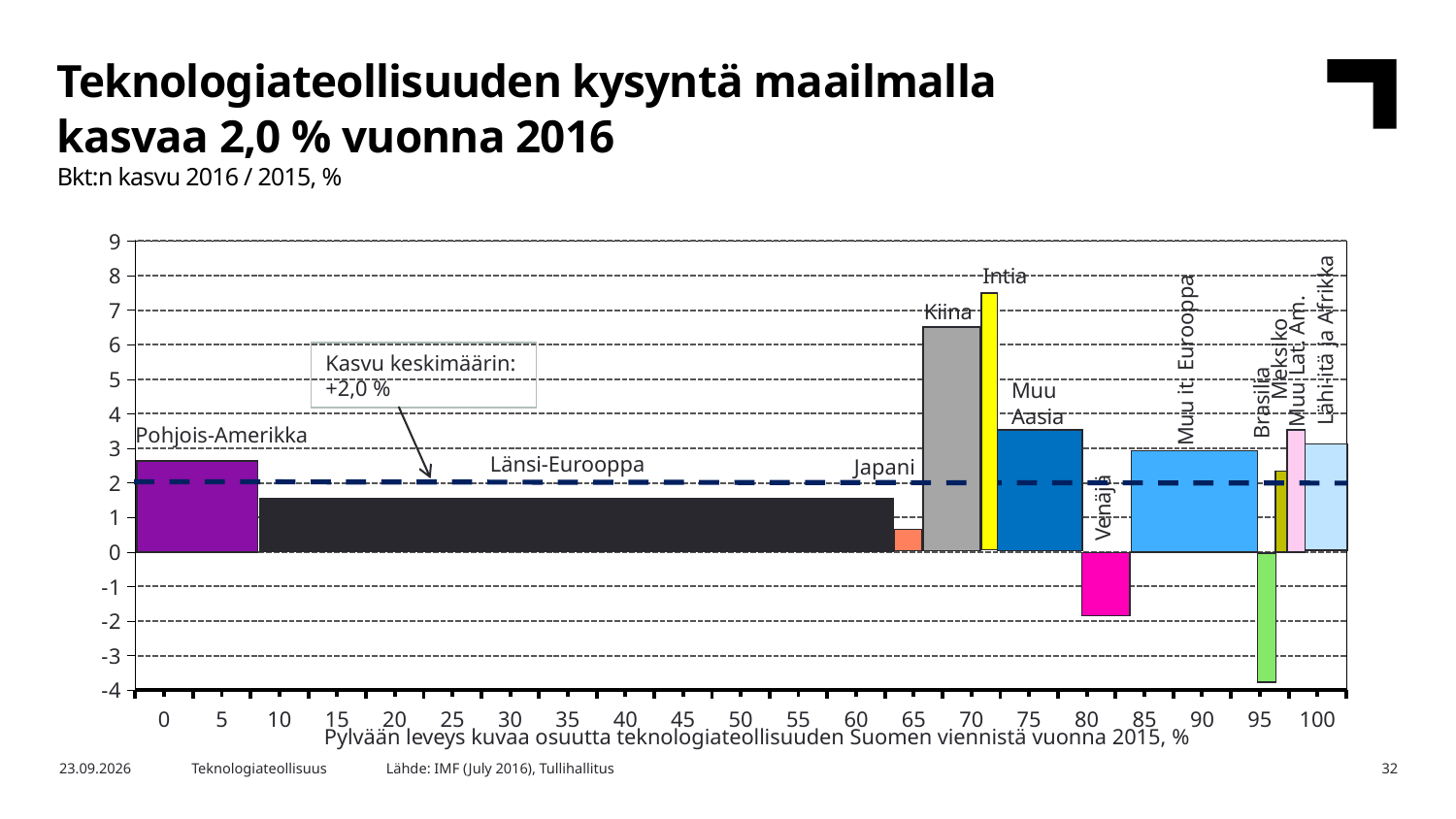
What average growth value is shown by the dashed line annotation in the chart? +2,0 % Is the value for Japani greater or less than 1? less Is the value for Länsi-Eurooppa greater or less than 2? less Which has the larger value, Pohjois-Amerikka or Länsi-Eurooppa? Pohjois-Amerikka Is the value for Venäjä greater or less than -1? less Which region has the highest GDP growth value in the chart? Intia Which has the larger value, Kiina or Muu Aasia? Kiina Which region has the lowest GDP growth value in the chart? Brasilia What kind of chart is shown on the slide? bar chart How many regions are plotted as bars in the chart? 12